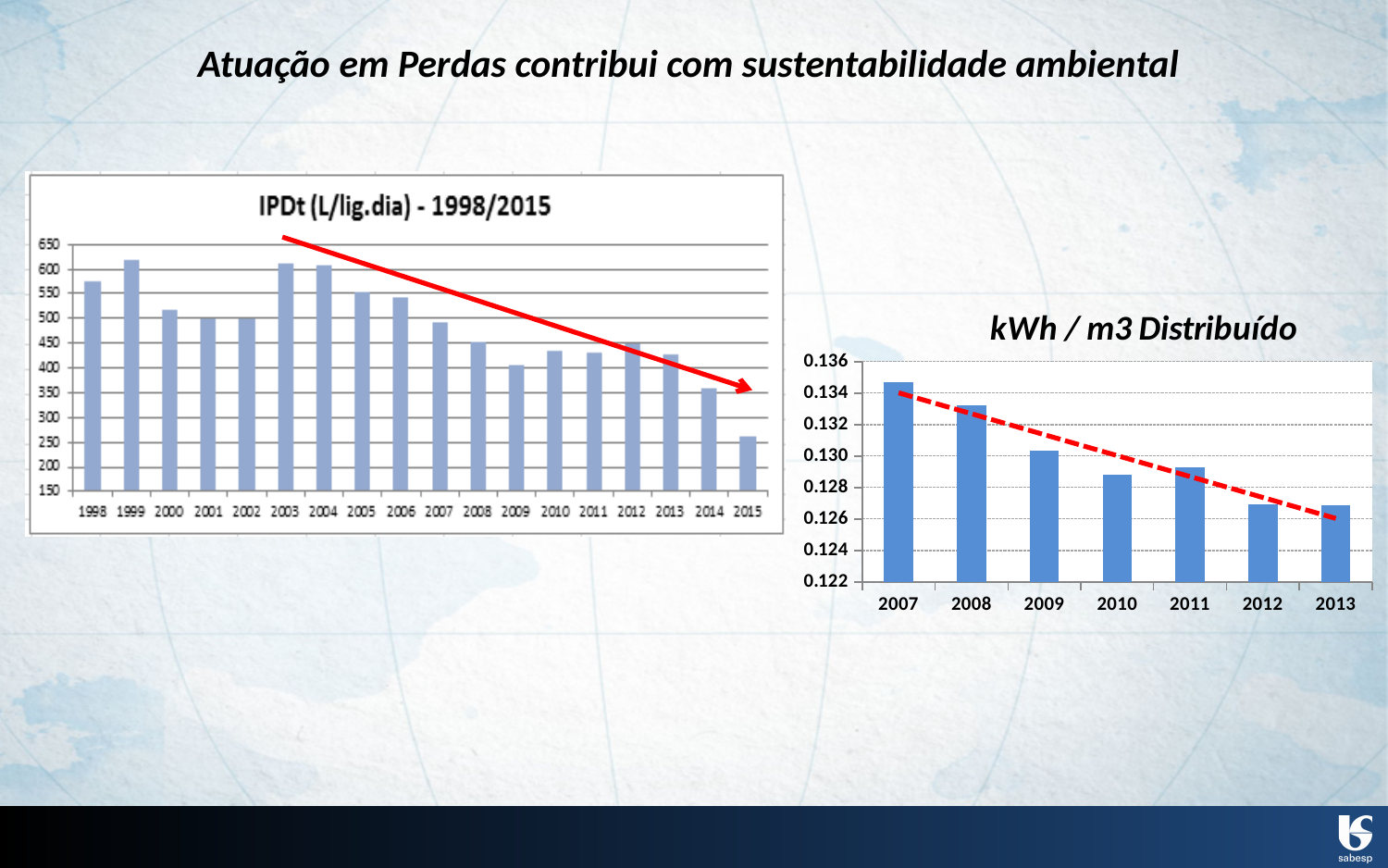
What type of chart is the 'IPDt (L/lig.dia) - 1998/2015' chart on the left? bar chart In the 'IPDt (L/lig.dia) - 1998/2015' chart, what is the overall trend of the values from 1998 to 2015? falling In the 'IPDt (L/lig.dia) - 1998/2015' chart, is the value for 2015 greater or less than 300? less In the 'kWh / m3 Distribuído' chart, which year has the highest value? 2007 What is the title of the chart on the right side of the slide? kWh / m3 Distribuído In the 'kWh / m3 Distribuído' chart, which is larger, the value for 2007 or the value for 2013? 2007 In the 'IPDt (L/lig.dia) - 1998/2015' chart, is the value for 1999 greater or less than 600? greater In the 'kWh / m3 Distribuído' chart, is the value for 2012 greater or less than 0.128? less How many years are shown on the x axis of the 'kWh / m3 Distribuído' chart on the right? 7 In the 'IPDt (L/lig.dia) - 1998/2015' chart, which year has the lowest value? 2015 In the 'IPDt (L/lig.dia) - 1998/2015' chart, which year has the highest value? 1999 How many years are shown on the x axis of the 'IPDt (L/lig.dia) - 1998/2015' chart? 18